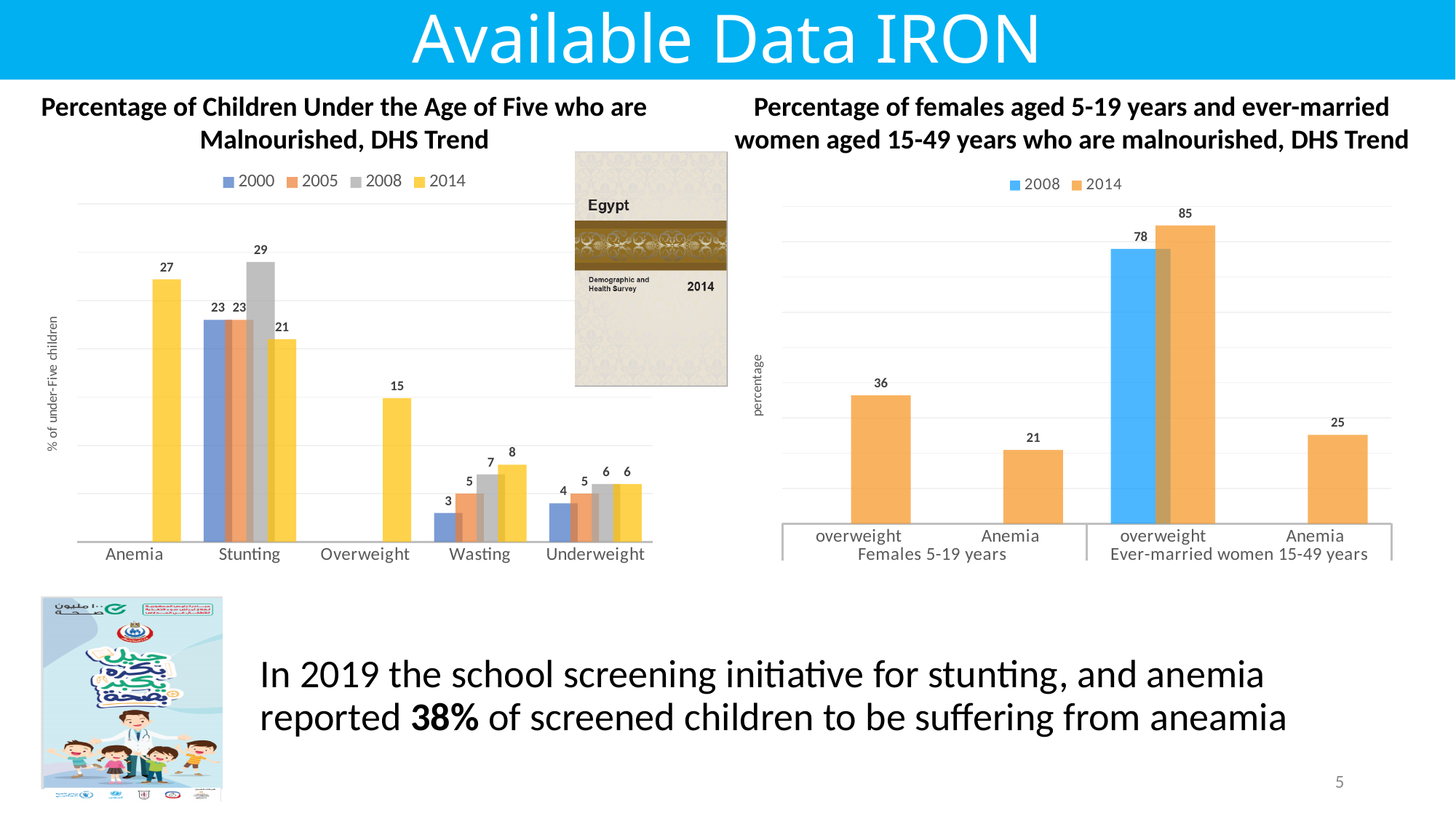
In the chart 'Percentage of Children Under the Age of Five who are Malnourished, DHS Trend', what is the difference between the 2008 and 2014 values for Stunting? 8 In the chart 'Percentage of Children Under the Age of Five who are Malnourished, DHS Trend', do the Wasting values rise or fall from 2000 to 2014? rise In the chart 'Percentage of Children Under the Age of Five who are Malnourished, DHS Trend', what is the 2014 value for Anemia? 27 In the chart 'Percentage of females aged 5-19 years and ever-married women aged 15-49 years who are malnourished, DHS Trend', what is the 2014 Anemia value for Females 5-19 years? 21 In the chart 'Percentage of Children Under the Age of Five who are Malnourished, DHS Trend', which category has the lowest 2000 value? Wasting What kind of chart is 'Percentage of females aged 5-19 years and ever-married women aged 15-49 years who are malnourished, DHS Trend'? bar chart In the chart 'Percentage of females aged 5-19 years and ever-married women aged 15-49 years who are malnourished, DHS Trend', what is the difference between the 2014 and 2008 overweight values for ever-married women 15-49 years? 7 In the chart 'Percentage of Children Under the Age of Five who are Malnourished, DHS Trend', how many series does the legend list? 4 In the chart 'Percentage of Children Under the Age of Five who are Malnourished, DHS Trend', what is the 2008 value for Stunting? 29 In the chart 'Percentage of females aged 5-19 years and ever-married women aged 15-49 years who are malnourished, DHS Trend', what is the 2014 overweight value for ever-married women 15-49 years? 85 In the chart 'Percentage of Children Under the Age of Five who are Malnourished, DHS Trend', how many categories are shown on the x axis? 5 In the chart 'Percentage of Children Under the Age of Five who are Malnourished, DHS Trend', what is the 2014 value for Overweight? 15